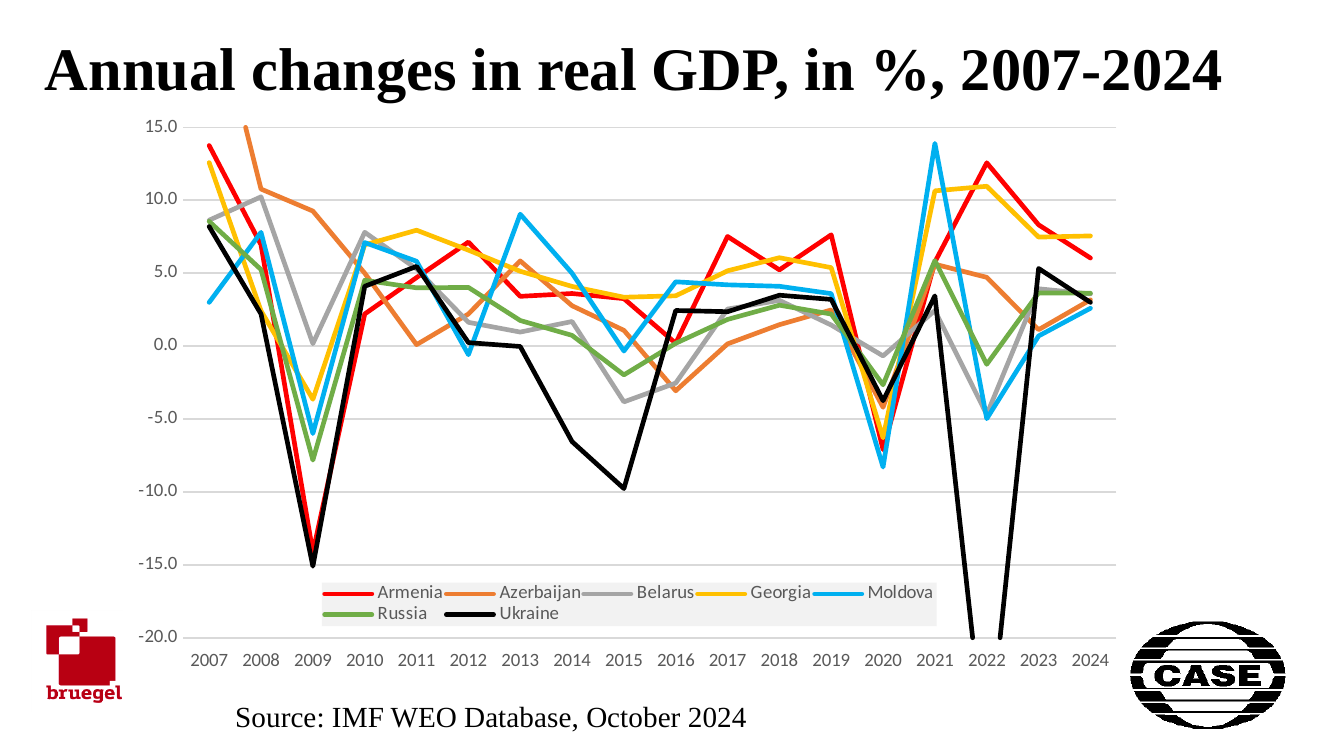
Which series has the highest value in 2021? Moldova Does the value for Ukraine rise or fall from 2013 to 2015? fall Is the value for Moldova in 2021 greater or less than 10? greater Which series is drawn with a black line? Ukraine Is the value for Ukraine in 2022 greater or less than -15? less What kind of chart is shown on the slide? Line chart Which series has the lowest value in 2015? Ukraine How many series does the legend list? 7 What is the title of the chart? Annual changes in real GDP, in %, 2007-2024 How many years are shown along the x axis? 18 Is the value for Armenia in 2009 greater or less than -10? less